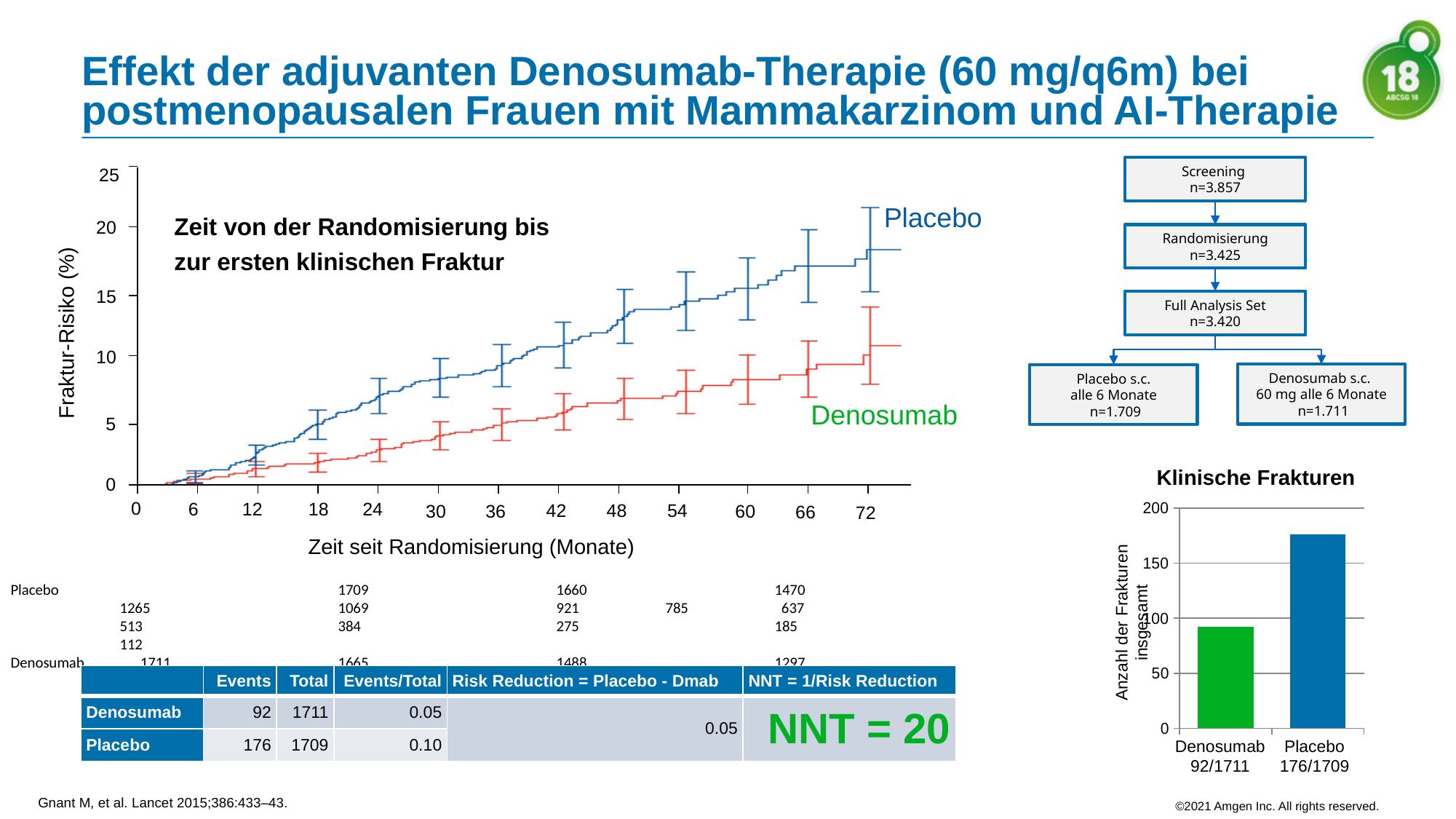
In the 'Klinische Frakturen' bar chart, what is the number of fractures for Denosumab? 92 What kind of chart is the 'Klinische Frakturen' chart? Bar chart In the line chart on the left, is the fracture risk for Placebo at 72 months greater or less than 15? greater In the line chart on the left, does the fracture risk for Placebo rise or fall over time since randomisation? Rise In the 'Klinische Frakturen' bar chart, how many categories are shown on the x axis? 2 In the line chart on the left, is the fracture risk for Denosumab at 36 months greater or less than 10? less In the 'Klinische Frakturen' bar chart, what is the difference in the number of fractures between Placebo and Denosumab? 84 In the 'Klinische Frakturen' bar chart, what is the number of fractures for Placebo? 176 What is the y-axis label of the line chart on the left? Fraktur-Risiko (%) In the 'Klinische Frakturen' bar chart, which group has the higher number of fractures? Placebo In the line chart on the left, which group has the higher fracture risk at 60 months, Placebo or Denosumab? Placebo In the 'Klinische Frakturen' bar chart, is the value for Placebo greater or less than 150? greater